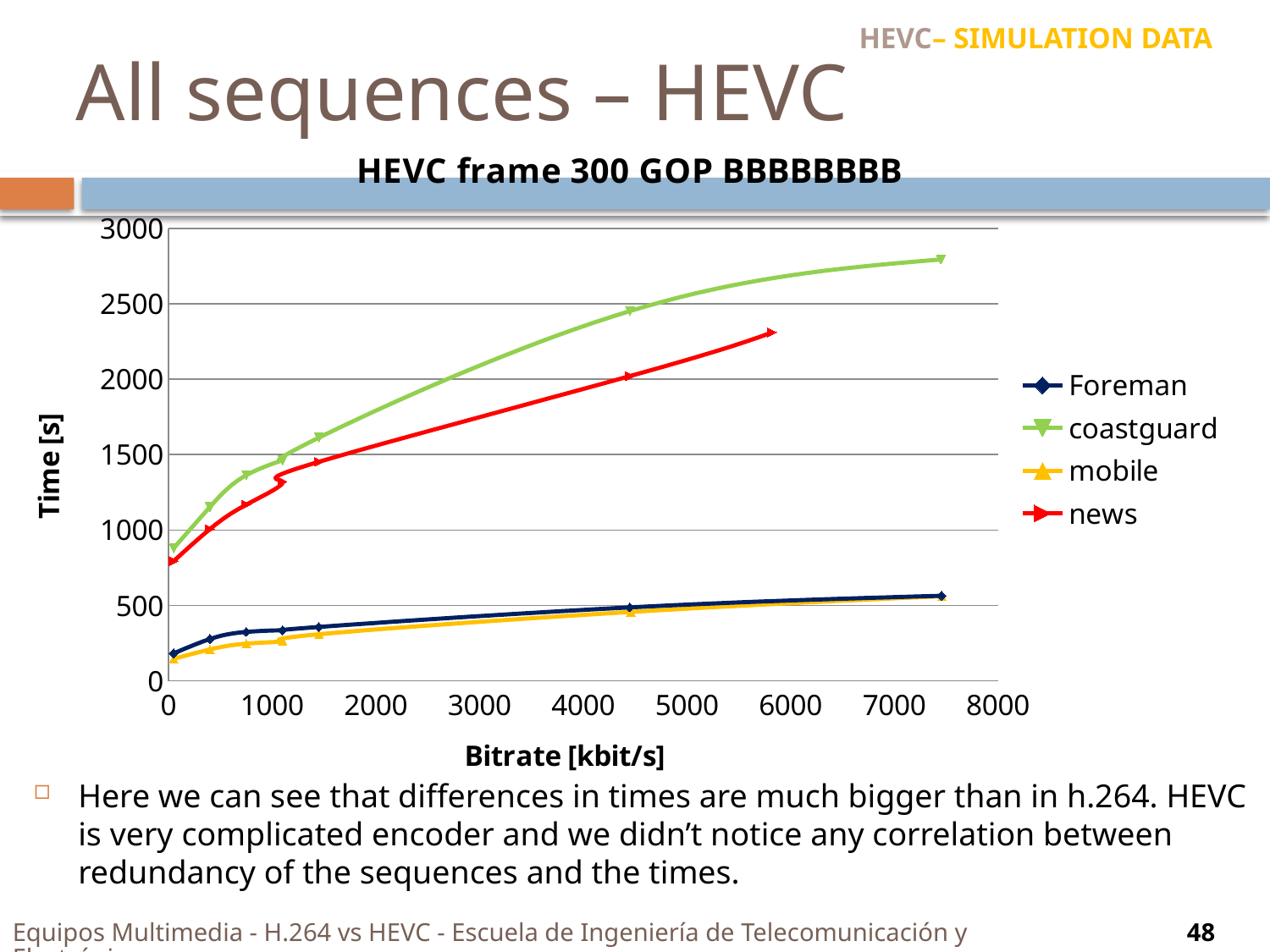
What kind of chart is shown on the slide? line chart What is the label of the vertical axis? Time [s] How many series does the legend list? 4 At a bitrate of about 1500 kbit/s, which series has the larger time: news or Foreman? news At a bitrate of about 4500 kbit/s, which series has the larger time: coastguard or news? coastguard Is the highest time value of the coastguard series greater or less than 2500? greater Is the highest time value of the news series greater or less than 2000? greater Does the time for the coastguard series rise or fall as bitrate increases? rise What is the title of the chart? HEVC frame 300 GOP BBBBBBBB Which series reaches the highest time value on the chart? coastguard Is the time for the Foreman series at its highest bitrate greater or less than 500? greater